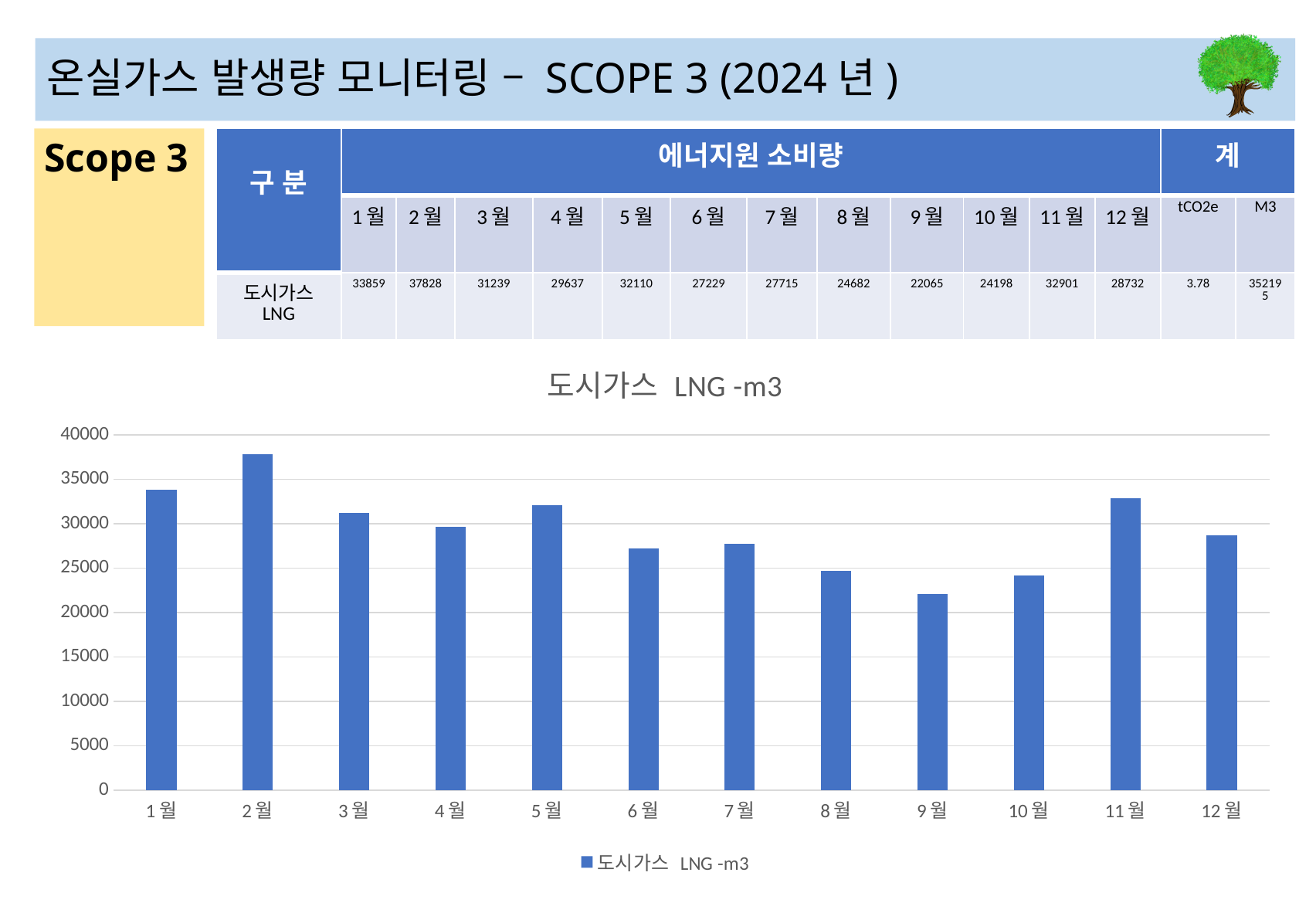
According to the table, what is the 도시가스 LNG value for 9월? 22065 How many months (categories) are plotted on the x axis of the chart? 12 Which is larger in the chart, the bar for 5월 or the bar for 6월? 5월 Which month has the highest bar in the chart? 2월 What is the title of the chart? 도시가스 LNG -m3 Is the bar for 4월 greater or less than 30000? less How many series does the chart legend list? 1 Do the bars rise or fall from 5월 to 9월? fall Which month has the lowest bar in the chart? 9월 What kind of chart is shown on the slide? bar chart Using the table values, what is the difference between the 2월 and 9월 values? 15763 According to the table, what is the 도시가스 LNG value for 2월? 37828